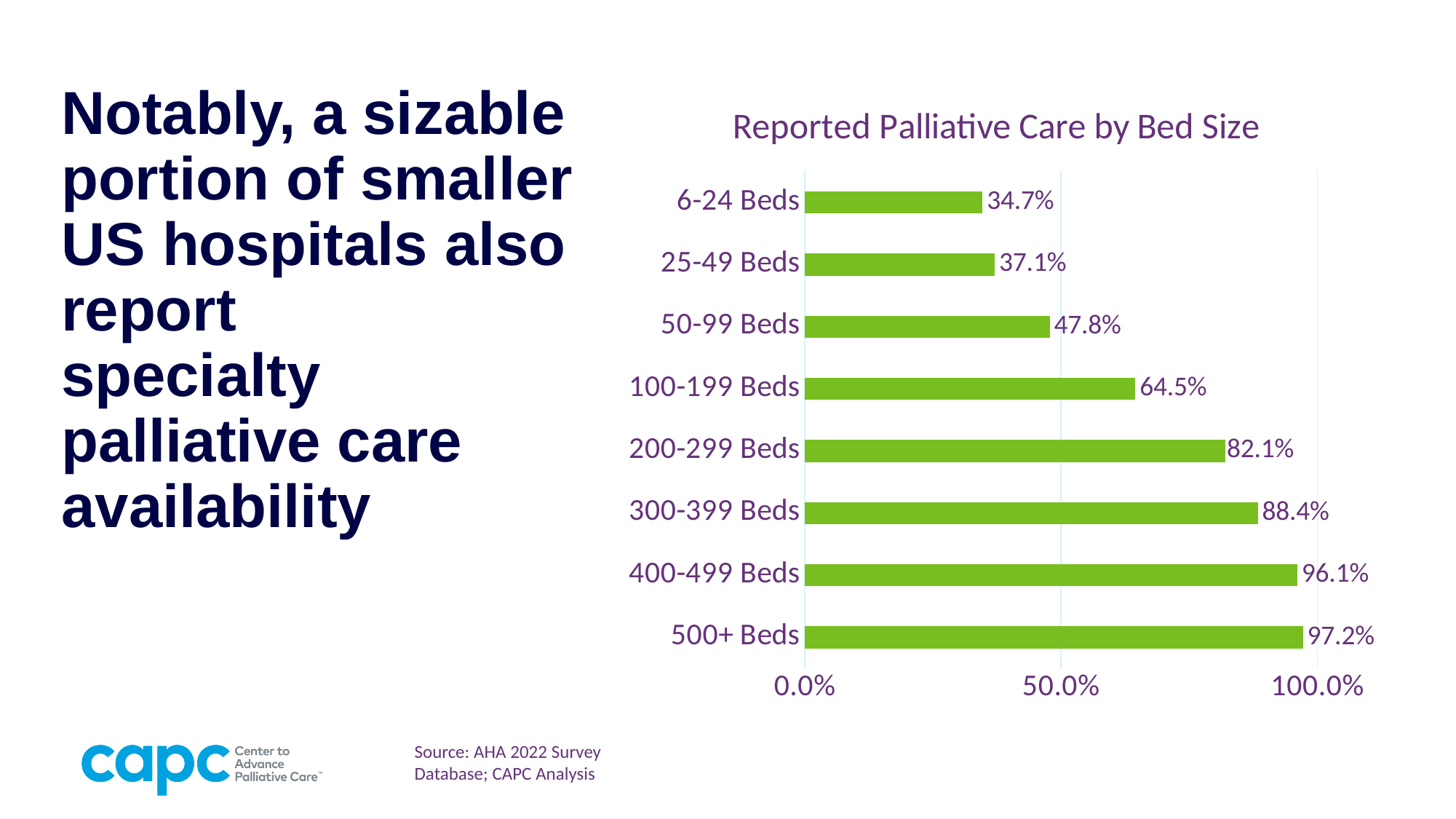
What is the difference between the values for 200-299 Beds and 50-99 Beds? 34.3% What is the title of the chart? Reported Palliative Care by Bed Size What is the reported palliative care value for hospitals with 100-199 beds? 64.5% What is the reported palliative care value for hospitals with 400-499 beds? 96.1% Is the value for 300-399 Beds greater or less than 50.0%? greater How many bed size categories are shown in the chart? 8 Which bed size category has the lowest reported palliative care value? 6-24 Beds Do the values rise or fall as bed size increases from 6-24 Beds to 500+ Beds? Rise Which has a higher value: 25-49 Beds or 50-99 Beds? 50-99 Beds What is the reported palliative care value for hospitals with 6-24 beds? 34.7% What kind of chart is shown on the slide? Bar chart Which bed size category has the highest reported palliative care value? 500+ Beds